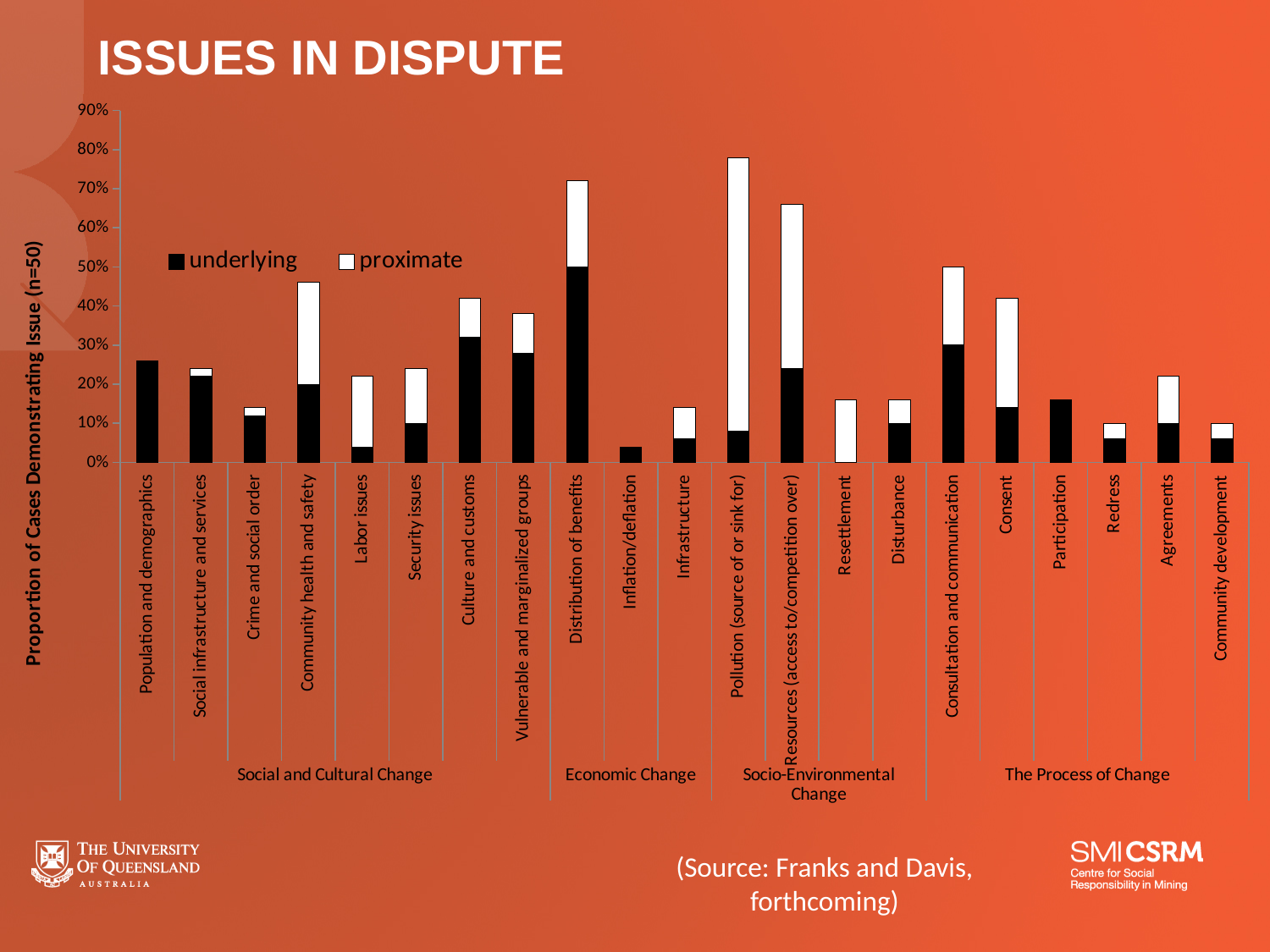
Which has the larger total bar, Consent or Participation? Consent Is the total value for Inflation/deflation greater or less than 10%? less Which issue has the largest underlying (black) portion? Distribution of benefits What are the two series named in the legend? underlying and proximate Which has the larger total bar, Pollution (source of or sink for) or Resources (access to/competition over)? Pollution (source of or sink for) Which issue has the tallest total bar? Pollution (source of or sink for) How many series does the legend list? 2 How many issue groups are labelled beneath the x axis? 4 Is the total value for Pollution (source of or sink for) greater or less than 70%? greater What kind of chart is shown on the slide? stacked bar chart Which issue has the shortest total bar? Inflation/deflation How many issue categories are plotted along the x axis? 21